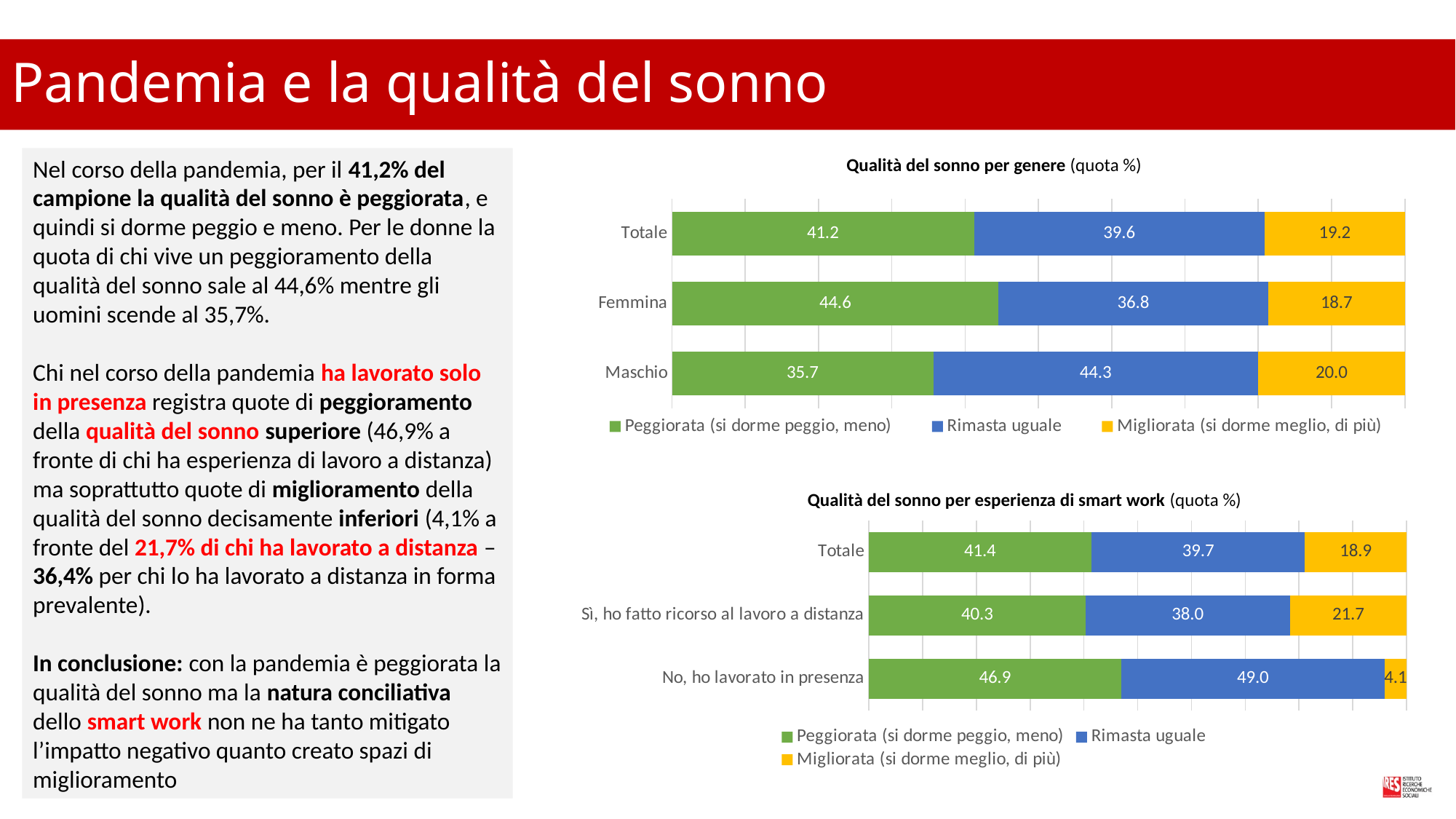
In the chart 'Qualità del sonno per genere', what is the value of 'Peggiorata (si dorme peggio, meno)' for Femmina? 44.6 In the chart 'Qualità del sonno per esperienza di smart work', is the 'Peggiorata' value larger for 'No, ho lavorato in presenza' or for 'Sì, ho fatto ricorso al lavoro a distanza'? No, ho lavorato in presenza In the chart 'Qualità del sonno per genere', what is the value of 'Migliorata (si dorme meglio, di più)' for Maschio? 20.0 In the chart 'Qualità del sonno per esperienza di smart work', what is the value of 'Rimasta uguale' for 'Sì, ho fatto ricorso al lavoro a distanza'? 38.0 In the chart 'Qualità del sonno per esperienza di smart work', what is the difference between the 'Migliorata' values for 'Sì, ho fatto ricorso al lavoro a distanza' and 'No, ho lavorato in presenza'? 17.6 What kind of chart is 'Qualità del sonno per genere'? Stacked bar chart In the chart 'Qualità del sonno per esperienza di smart work', how many categories are shown? 3 In the chart 'Qualità del sonno per genere', which category has the highest value for 'Rimasta uguale'? Maschio In the chart 'Qualità del sonno per esperienza di smart work', what is the value of 'Migliorata (si dorme meglio, di più)' for 'No, ho lavorato in presenza'? 4.1 In the chart 'Qualità del sonno per genere', what is the difference between the 'Peggiorata' values for Femmina and Maschio? 8.9 In the chart 'Qualità del sonno per esperienza di smart work', which category has the lowest value for 'Migliorata (si dorme meglio, di più)'? No, ho lavorato in presenza In the chart 'Qualità del sonno per genere', how many series does the legend list? 3